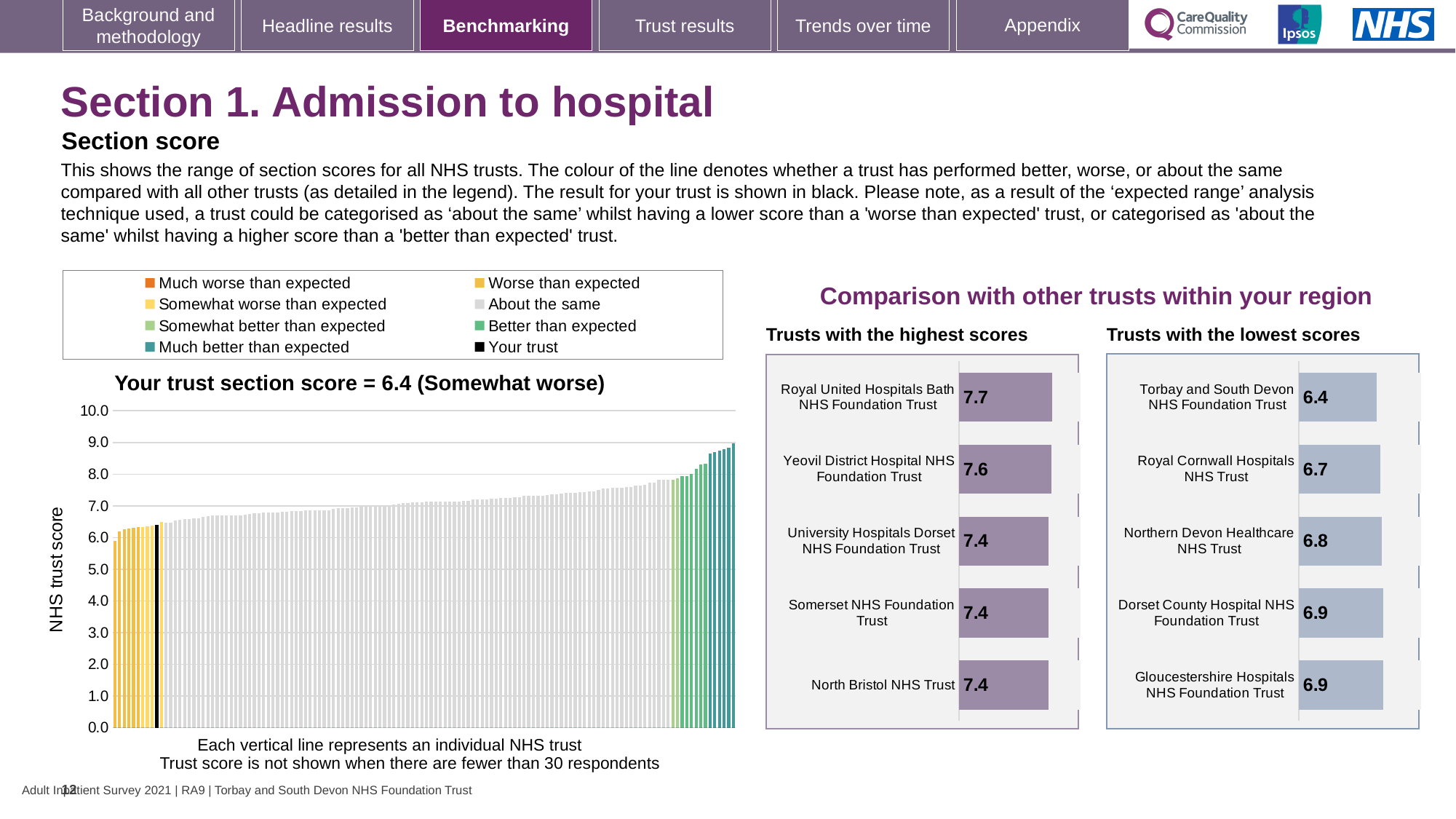
In the 'Your trust section score' chart, is the value of the rightmost (highest) bar greater or less than 8.0? greater In the 'Your trust section score' chart, what is the section score for your trust? 6.4 In the 'Trusts with the lowest scores' chart, which has the larger score: Royal Cornwall Hospitals NHS Trust or Northern Devon Healthcare NHS Trust? Northern Devon Healthcare NHS Trust In the 'Trusts with the highest scores' chart, what is the score for Royal United Hospitals Bath NHS Foundation Trust? 7.7 In the 'Trusts with the highest scores' chart, what is the difference between the scores of Royal United Hospitals Bath NHS Foundation Trust and Yeovil District Hospital NHS Foundation Trust? 0.1 In the 'Trusts with the lowest scores' chart, how many trusts are shown? 5 In the 'Trusts with the highest scores' chart, which trust has the highest score? Royal United Hospitals Bath NHS Foundation Trust In the 'Your trust section score' chart, what kind of chart is used to show the NHS trust scores? Bar chart In the 'Your trust section score' chart, do the trust scores rise or fall from left to right along the x axis? Rise In the 'Your trust section score' chart, what is the label on the vertical axis? NHS trust score In the 'Trusts with the lowest scores' chart, which trust has the lowest score? Torbay and South Devon NHS Foundation Trust How many entries does the legend above the 'Your trust section score' chart list? 8